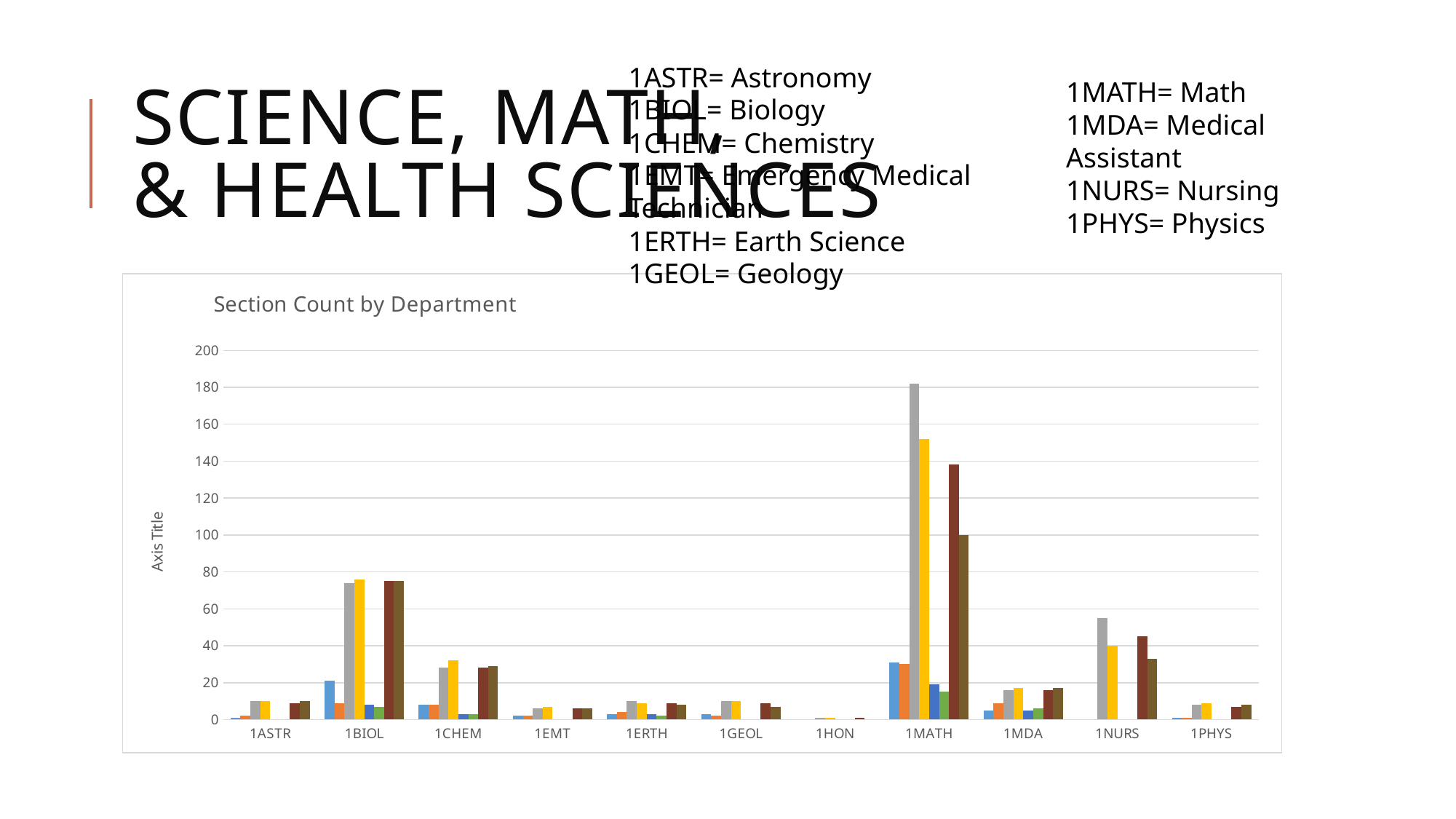
How many department categories are shown on the x axis of the chart? 11 What kind of chart is shown on the slide? bar chart Which department has the smallest bars in the chart? 1HON What is the title of the chart? Section Count by Department Is the tallest bar for 1CHEM greater or less than 40? less Is the tallest bar for 1MATH greater or less than 160? greater Is the tallest bar for 1BIOL greater or less than 60? greater Which department has a taller tallest bar, 1NURS or 1MDA? 1NURS What is the label shown on the vertical axis of the chart? Axis Title Which department has a taller tallest bar, 1MATH or 1BIOL? 1MATH Which department has the tallest bar in the chart? 1MATH